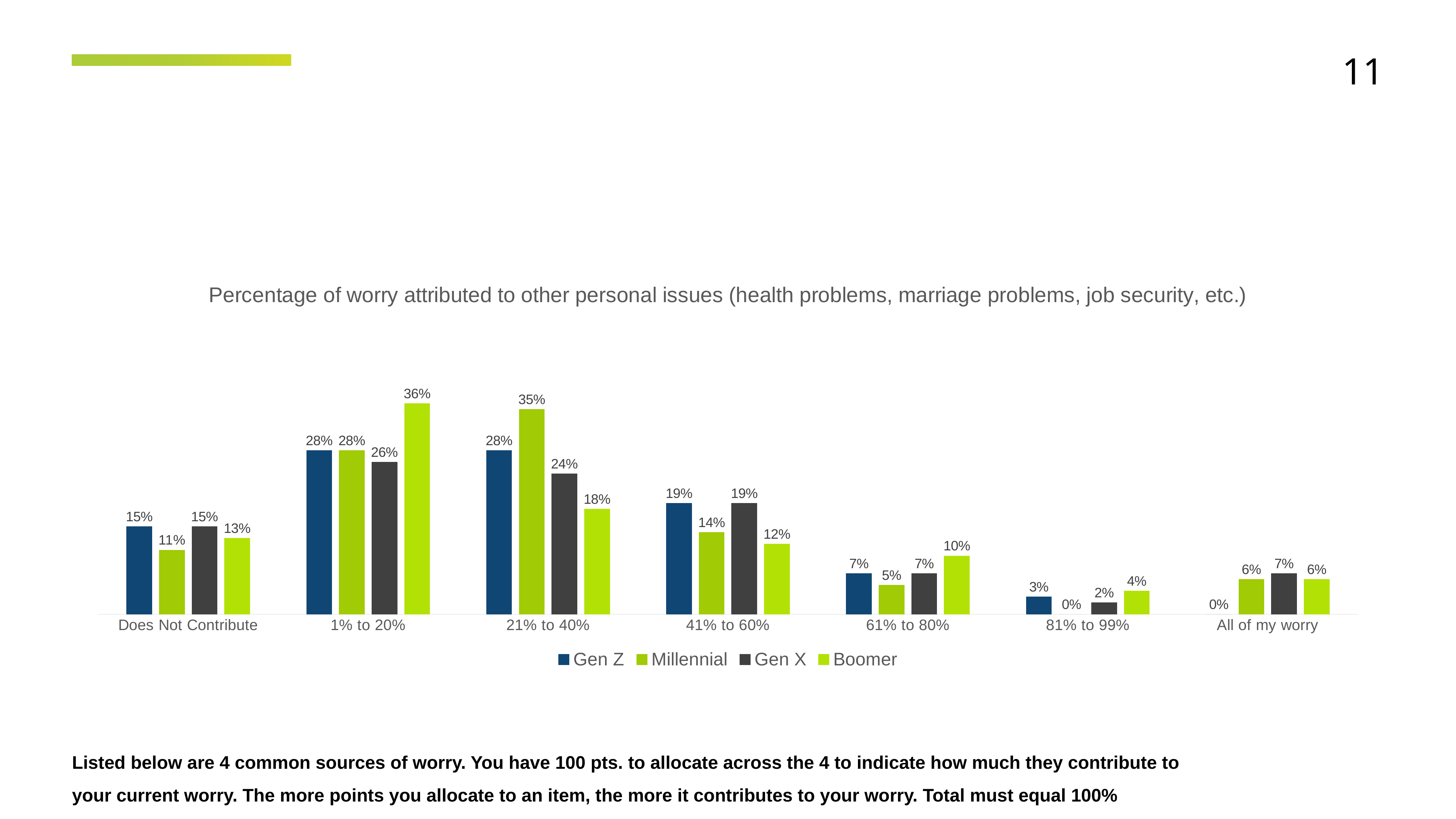
In the "21% to 40%" category, which is larger: the Gen X value or the Boomer value? Gen X How many categories are shown on the x axis? 7 Which category has the highest Boomer value? 1% to 20% What is the Millennial value for the "21% to 40%" category? 35% What is the Gen Z value for the "All of my worry" category? 0% What is the difference between the Millennial and Boomer values in the "41% to 60%" category? 2% How many series does the legend list? 4 Which series is shown in dark blue in the legend? Gen Z What is the Boomer value for the "1% to 20%" category? 36% What is the Gen X value for the "Does Not Contribute" category? 15% Which category has the lowest Gen Z value? All of my worry What kind of chart is shown on the slide? Bar chart